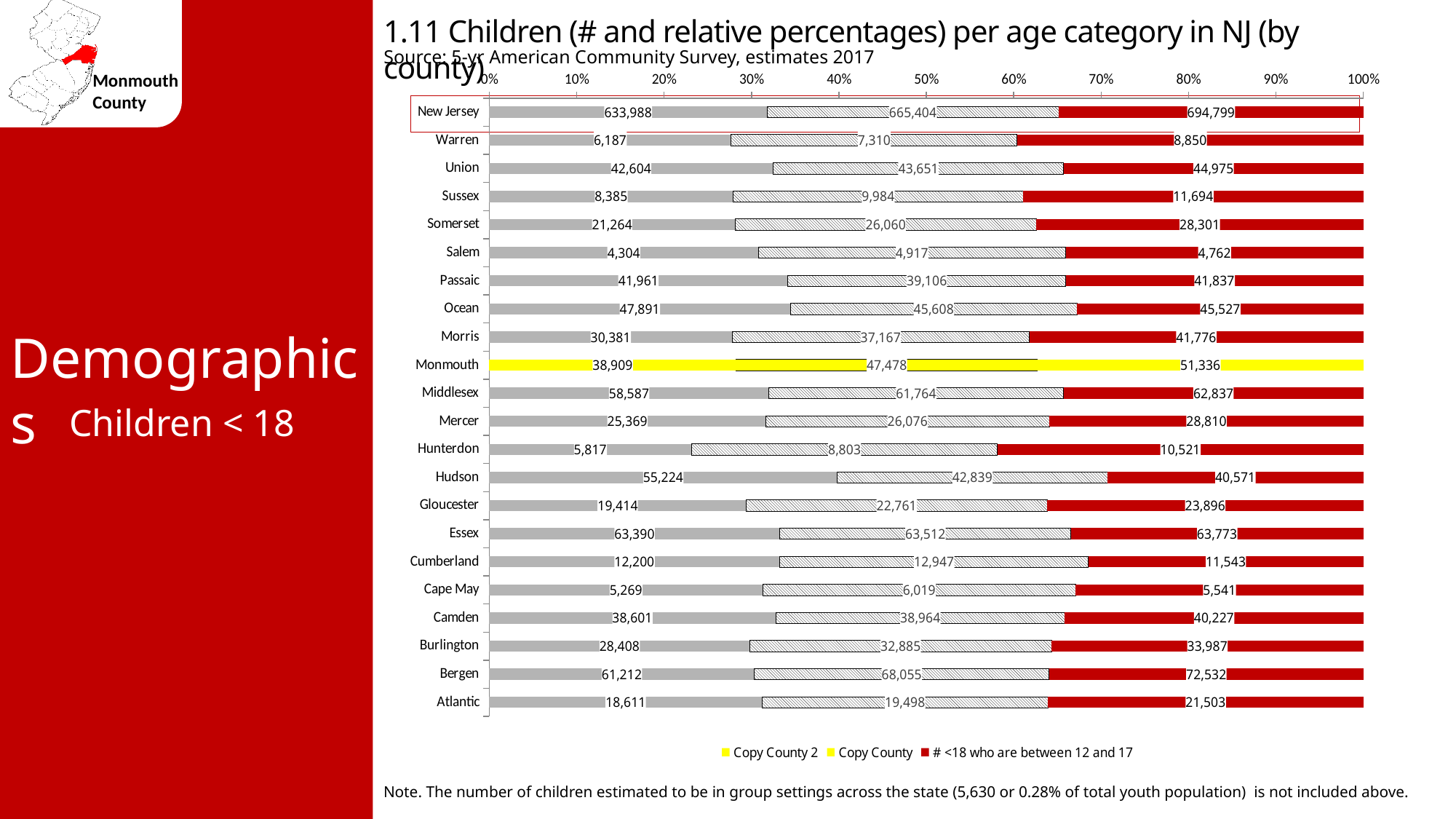
How many categories (New Jersey plus counties) are listed on the vertical axis of the chart? 22 What is the value of the '# <18 who are between 12 and 17' segment for Monmouth? 51,336 What is the value of the '# <18 who are between 12 and 17' segment for New Jersey? 694,799 What type of chart is shown on the slide? bar chart How many entries does the chart legend list? 3 Which county's bar is highlighted in yellow on the chart? Monmouth What is the value of the leftmost segment of the Monmouth bar? 38,909 Among the counties (excluding New Jersey), which has the highest value for '# <18 who are between 12 and 17'? Bergen Among the counties, which has the lowest value for '# <18 who are between 12 and 17'? Salem What is the total of the three segments of the Monmouth bar? 137,723 What is the difference between Bergen's and Monmouth's '# <18 who are between 12 and 17' values? 21,196 Which is larger, the '# <18 who are between 12 and 17' value for Ocean or for Passaic? Ocean